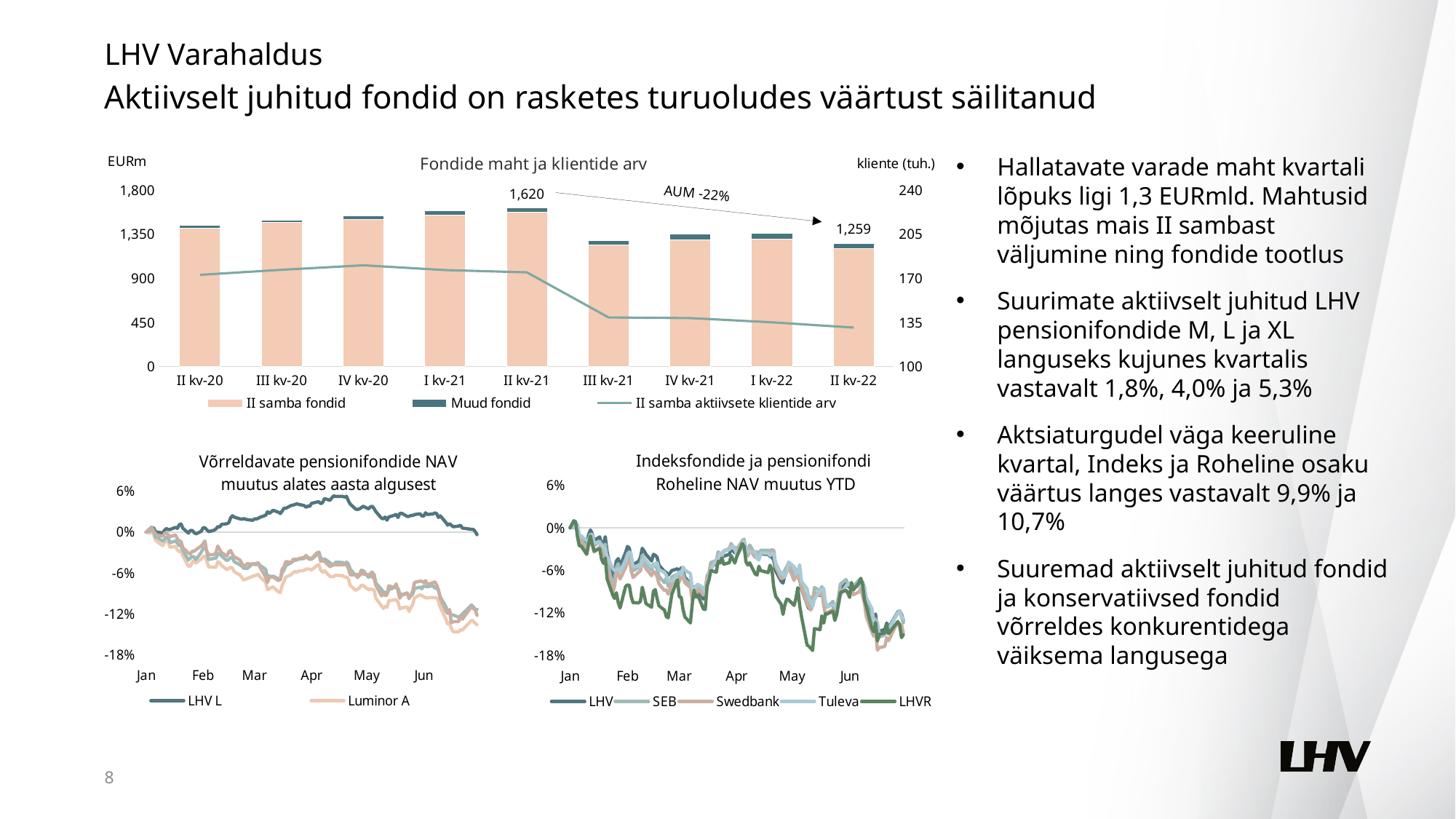
How many series does the legend of the 'Indeksfondide ja pensionifondi Roheline NAV muutus YTD' chart list? 5 In the 'Fondide maht ja klientide arv' chart, what is the difference between the labelled values for II kv-21 and II kv-22? 361 In the 'Fondide maht ja klientide arv' chart, what value is labelled for II kv-21? 1,620 In the 'Fondide maht ja klientide arv' chart, does the 'II samba aktiivsete klientide arv' line rise or fall between II kv-21 and III kv-21? fall In the 'Indeksfondide ja pensionifondi Roheline NAV muutus YTD' chart, which series reaches the lowest point in May? LHVR In the 'Fondide maht ja klientide arv' chart, what value is labelled for II kv-22? 1,259 How many series does the legend of the 'Fondide maht ja klientide arv' chart list? 3 What percentage change in AUM is annotated on the 'Fondide maht ja klientide arv' chart? -22% In the 'Võrreldavate pensionifondide NAV muutus alates aasta algusest' chart, which series ends higher at the end of June, LHV L or Luminor A? LHV L In the 'Fondide maht ja klientide arv' chart, is the bar for III kv-21 greater or less than 1,350? less How many quarters are shown on the x axis of the 'Fondide maht ja klientide arv' chart? 9 In the 'Fondide maht ja klientide arv' chart, which quarter has the tallest bar? II kv-21